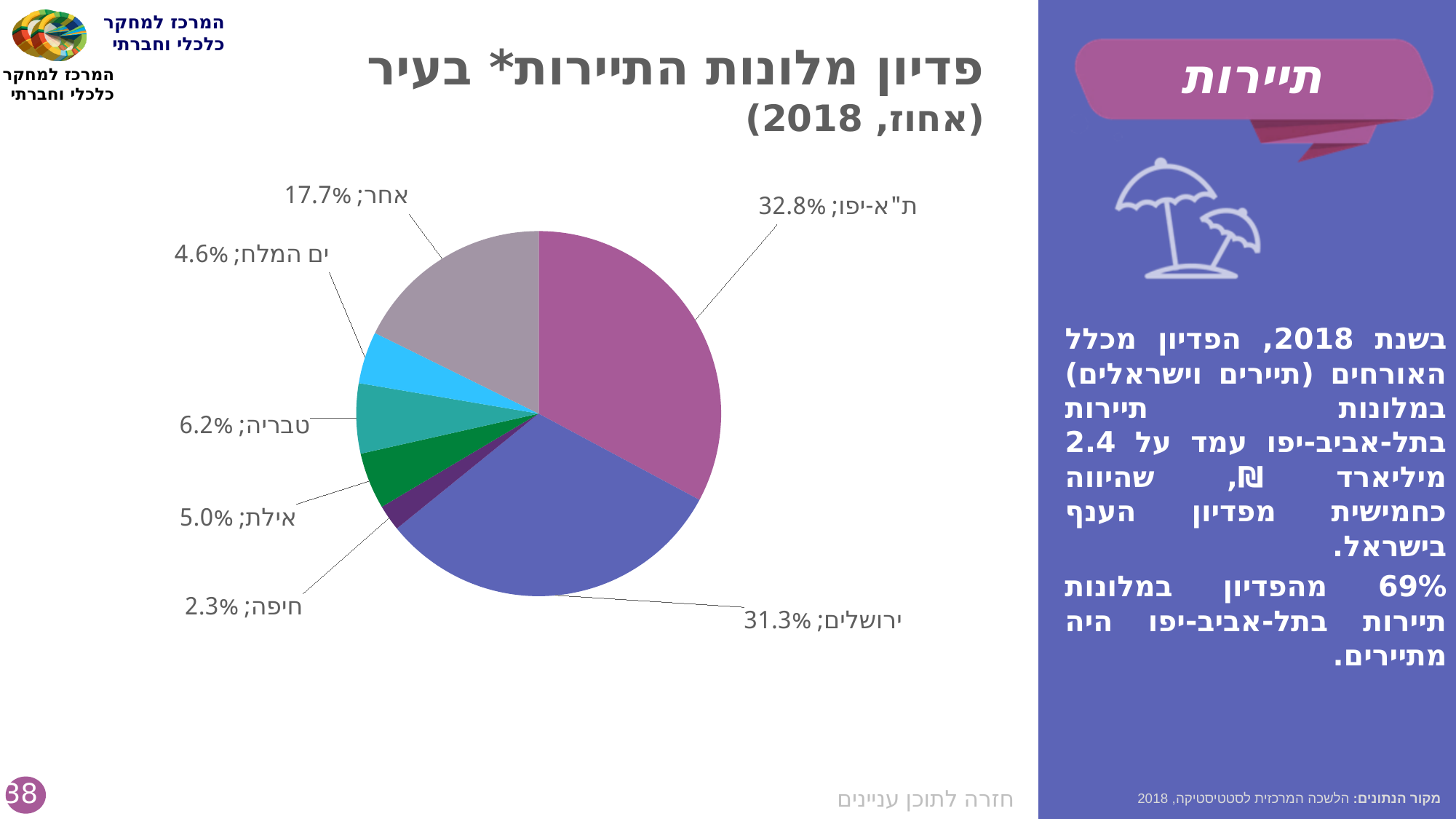
Which is larger, the slice for טבריה or the slice for אילת? טבריה What percentage is shown for ים המלח (Dead Sea)? 4.6% What is the value shown for ירושלים (Jerusalem) in the pie chart? 31.3% What percentage is shown for אילת (Eilat)? 5.0% Which category has the smallest slice of the pie chart? חיפה How many slices does the pie chart have? 7 What kind of chart is shown on the slide? pie chart What year does the chart title say the data refers to? 2018 What is the difference in percentage points between ת"א-יפו and ירושלים? 1.5 What is the combined share of ת"א-יפו and ירושלים? 64.1% What share of tourism hotel revenue does ת"א-יפו (Tel Aviv-Yafo) have in the pie chart? 32.8% Which city has the largest slice of the pie chart? ת"א-יפו